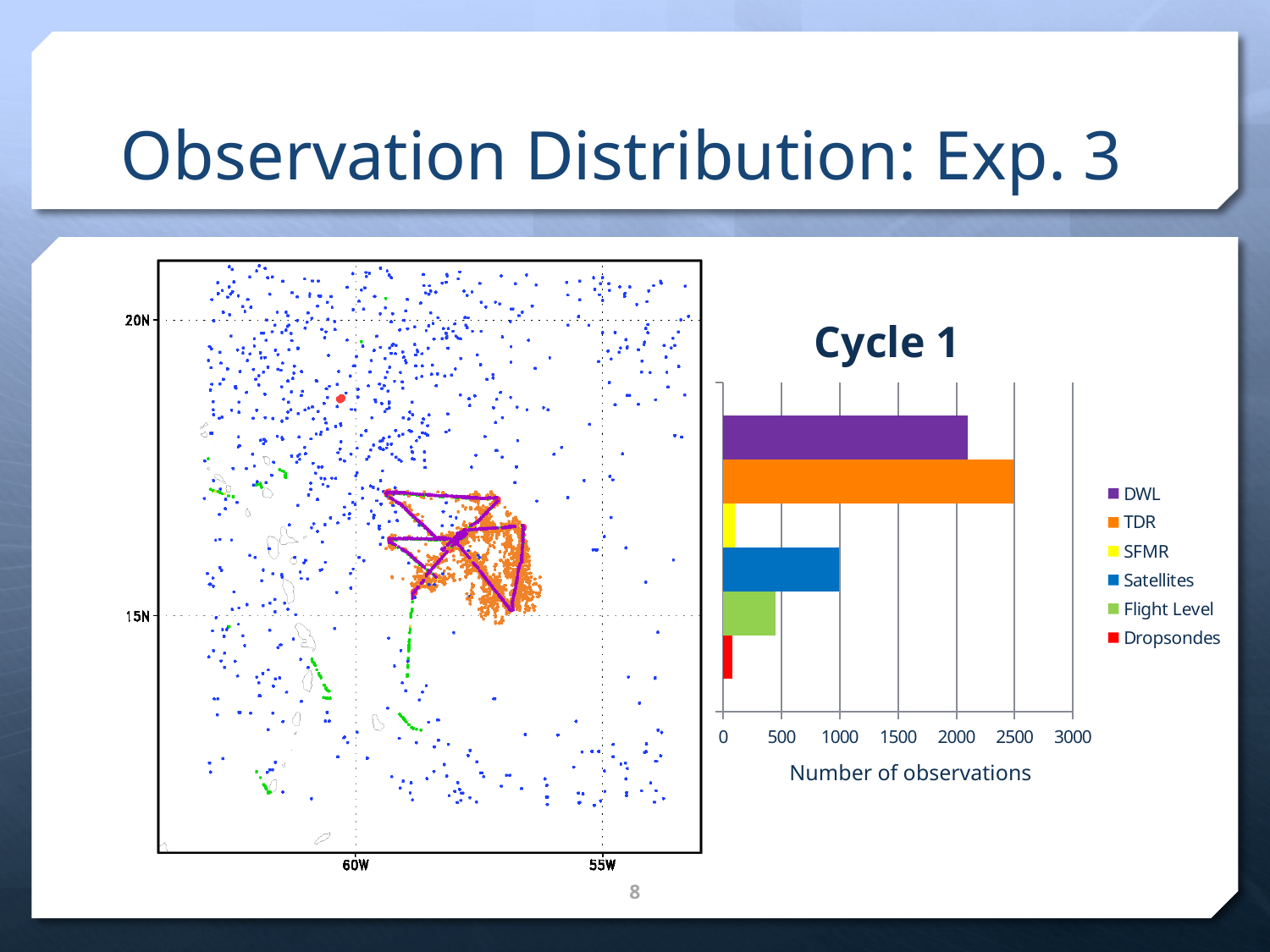
In the 'Cycle 1' chart, what colour is the TDR bar? orange In the 'Cycle 1' chart, is the value for SFMR greater or less than 500? less In the 'Cycle 1' chart, which is larger, the value for Satellites or the value for Flight Level? Satellites In the 'Cycle 1' chart, is the value for DWL greater or less than 2500? less In the 'Cycle 1' chart, which is larger, the value for DWL or the value for TDR? TDR What is the x-axis label of the 'Cycle 1' chart? Number of observations In the 'Cycle 1' chart, which series has the highest number of observations? TDR In the 'Cycle 1' chart, how many series does the legend list? 6 In the 'Cycle 1' chart, is the value for Flight Level greater or less than 500? less What kind of chart is the 'Cycle 1' chart on the right of the slide? bar chart